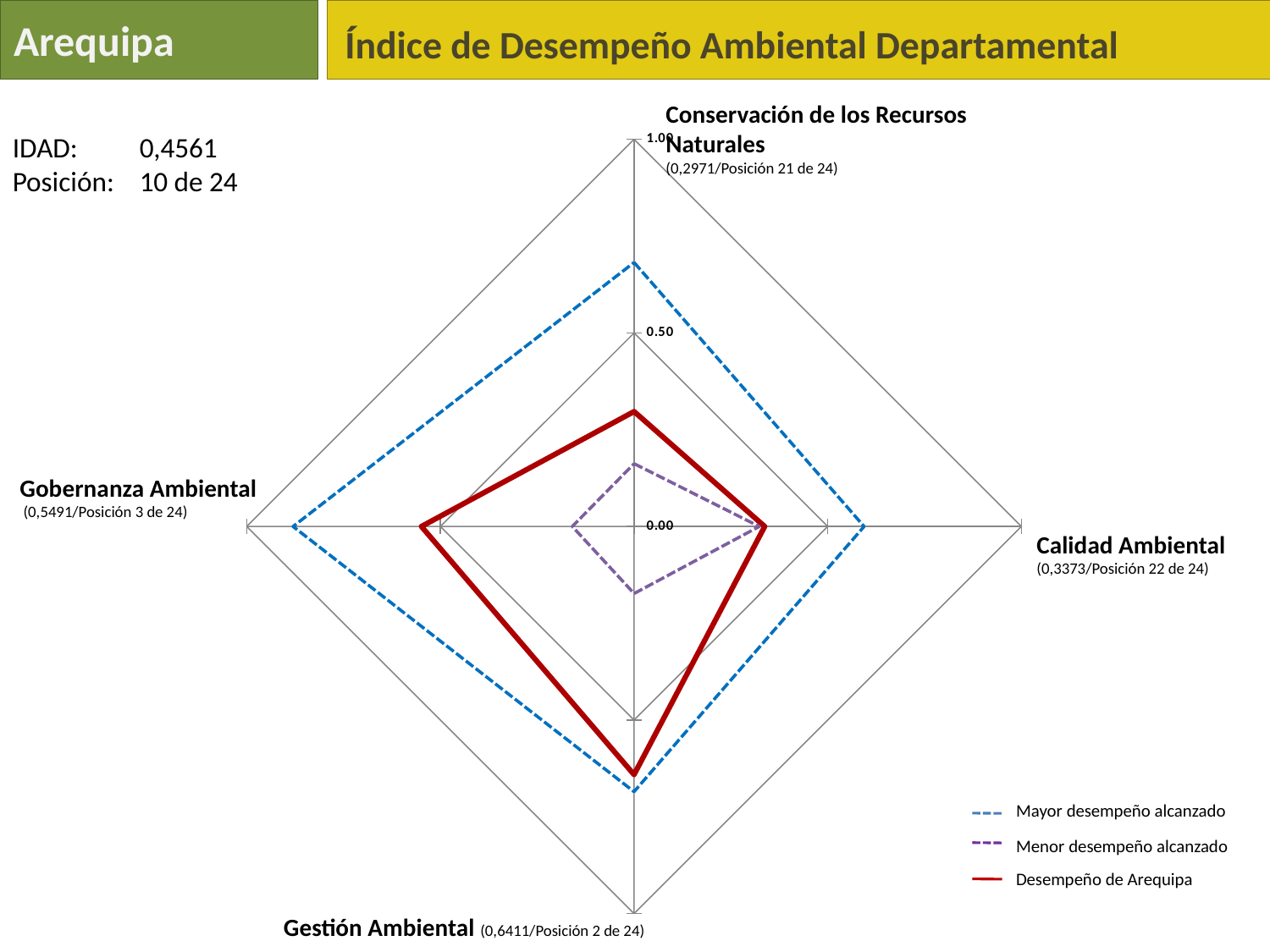
Which legend entry is drawn as a solid red line? Desempeño de Arequipa What is Arequipa's value for Conservación de los Recursos Naturales? 0,2971 How many axes (categories) does the radar chart have? 4 Is Arequipa's value for Gobernanza Ambiental greater or less than 0.50? greater How many series does the legend list? 3 What kind of chart is shown on the slide? radar chart What position does Arequipa hold for Gobernanza Ambiental? 3 de 24 Which is larger for Arequipa: Calidad Ambiental or Gobernanza Ambiental? Gobernanza Ambiental What is Arequipa's value for Calidad Ambiental? 0,3373 What is Arequipa's value for Gestión Ambiental? 0,6411 In which category does Arequipa have its highest value? Gestión Ambiental In which category does Arequipa have its lowest value? Conservación de los Recursos Naturales